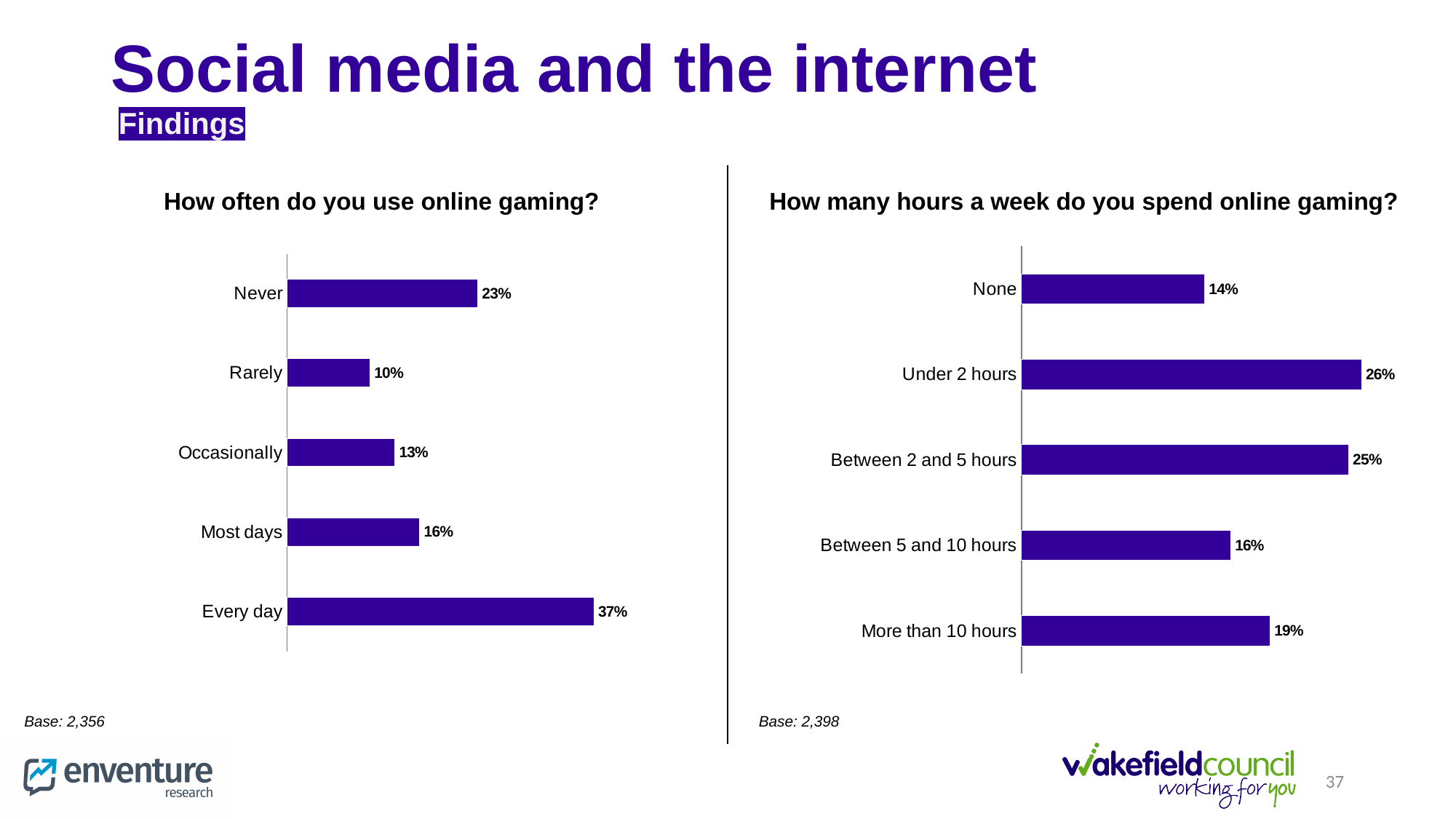
In the 'How many hours a week do you spend online gaming?' chart, which category has the highest value? Under 2 hours In the 'How often do you use online gaming?' chart, which is larger: 'Occasionally' or 'Most days'? Most days In the 'How often do you use online gaming?' chart, how many categories are shown? 5 In the 'How many hours a week do you spend online gaming?' chart, which is larger: 'None' or 'More than 10 hours'? More than 10 hours What is the base (number of respondents) shown for the 'How often do you use online gaming?' chart? 2,356 In the 'How many hours a week do you spend online gaming?' chart, what percentage of respondents said 'Between 5 and 10 hours'? 16% In the 'How often do you use online gaming?' chart, what percentage of respondents said 'Every day'? 37% What type of chart is used for 'How many hours a week do you spend online gaming?'? Bar chart In the 'How often do you use online gaming?' chart, what is the difference between 'Never' and 'Most days'? 7% In the 'How many hours a week do you spend online gaming?' chart, which category has the lowest value? None In the 'How many hours a week do you spend online gaming?' chart, what is the difference between 'More than 10 hours' and 'None'? 5% In the 'How often do you use online gaming?' chart, which category has the lowest value? Rarely